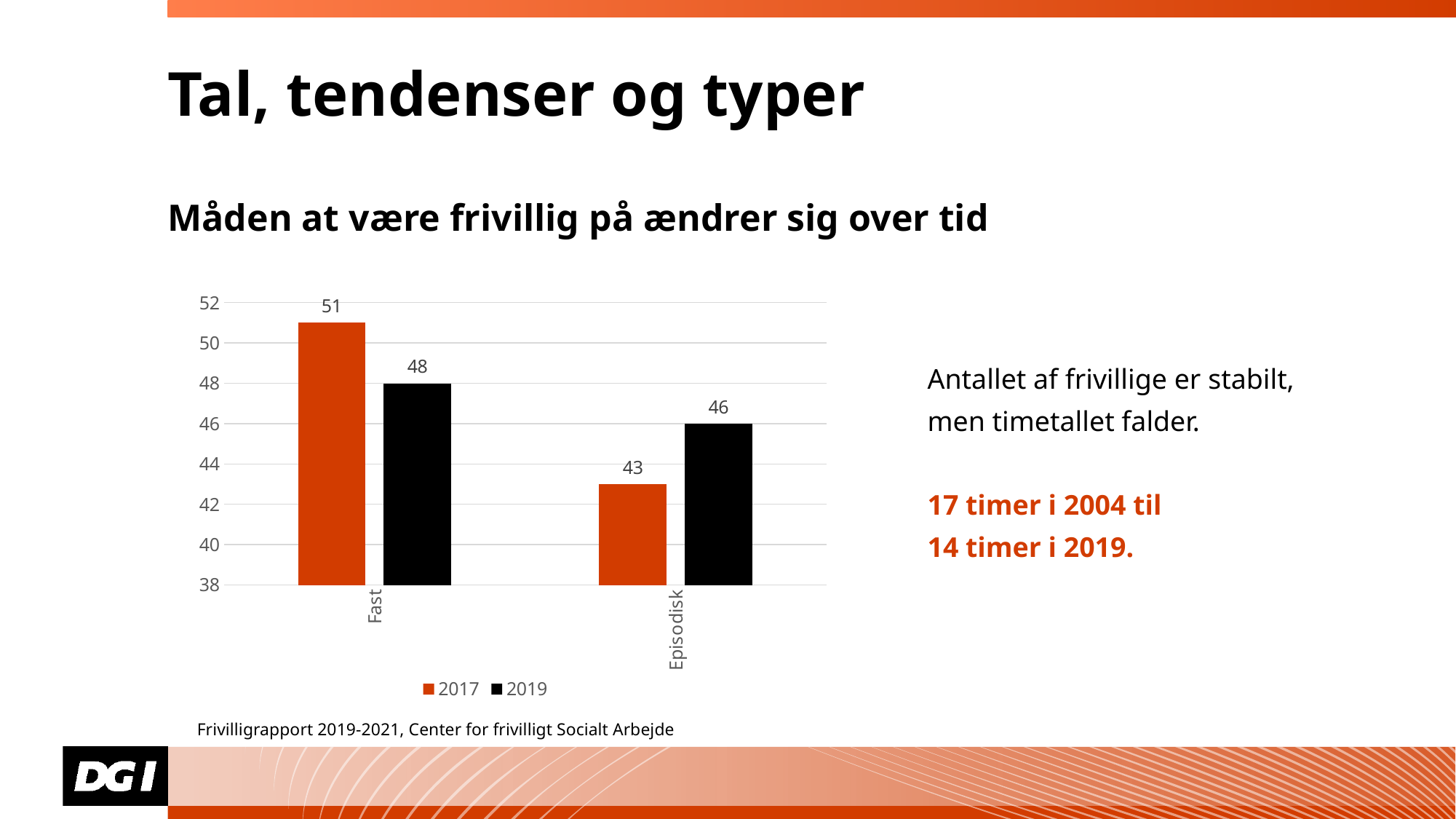
How many categories are shown on the x axis? 2 What kind of chart is shown on the slide? Bar chart What is the value for Fast in the 2017 series? 51 What is the difference between the 2019 and 2017 values for Episodisk? 3 What is the value for Episodisk in the 2019 series? 46 What is the difference between the 2017 and 2019 values for Fast? 3 What is the value for Fast in the 2019 series? 48 Which is larger for Episodisk: the 2017 value or the 2019 value? 2019 Which category has the highest value in the 2017 series? Fast What is the value for Episodisk in the 2017 series? 43 How many series does the legend list? 2 Which category has the lowest value in the 2019 series? Episodisk